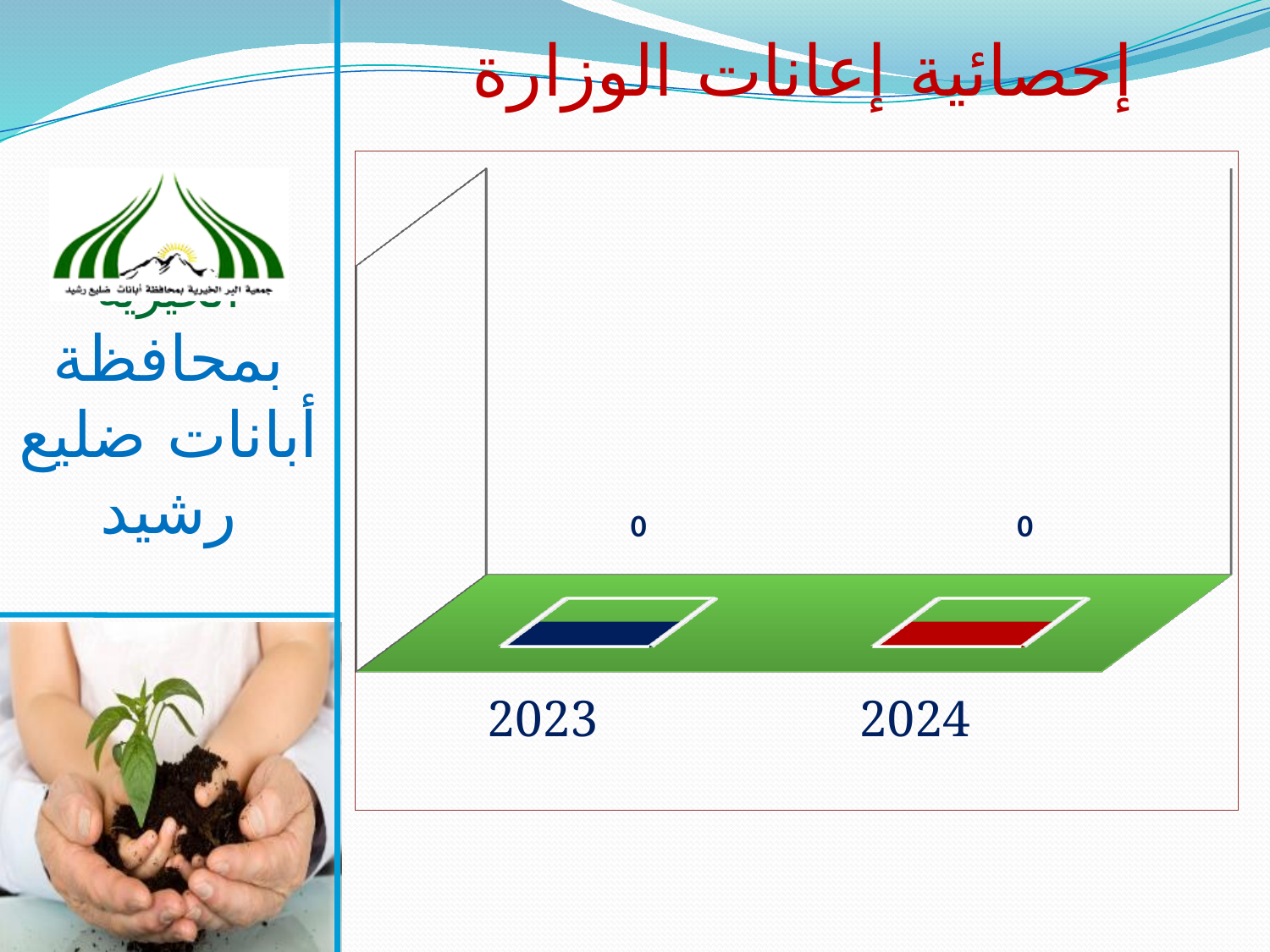
What is the value shown for 2024? 0 What colour is the bar for 2024? Red What is the value shown for 2023? 0 Do the values rise, fall, or stay the same from 2023 to 2024? Stay the same How many categories are shown on the x axis of the chart? 2 What kind of chart is shown on the slide? Bar chart Which years are shown as categories on the chart? 2023 and 2024 What is the difference between the values for 2023 and 2024? 0